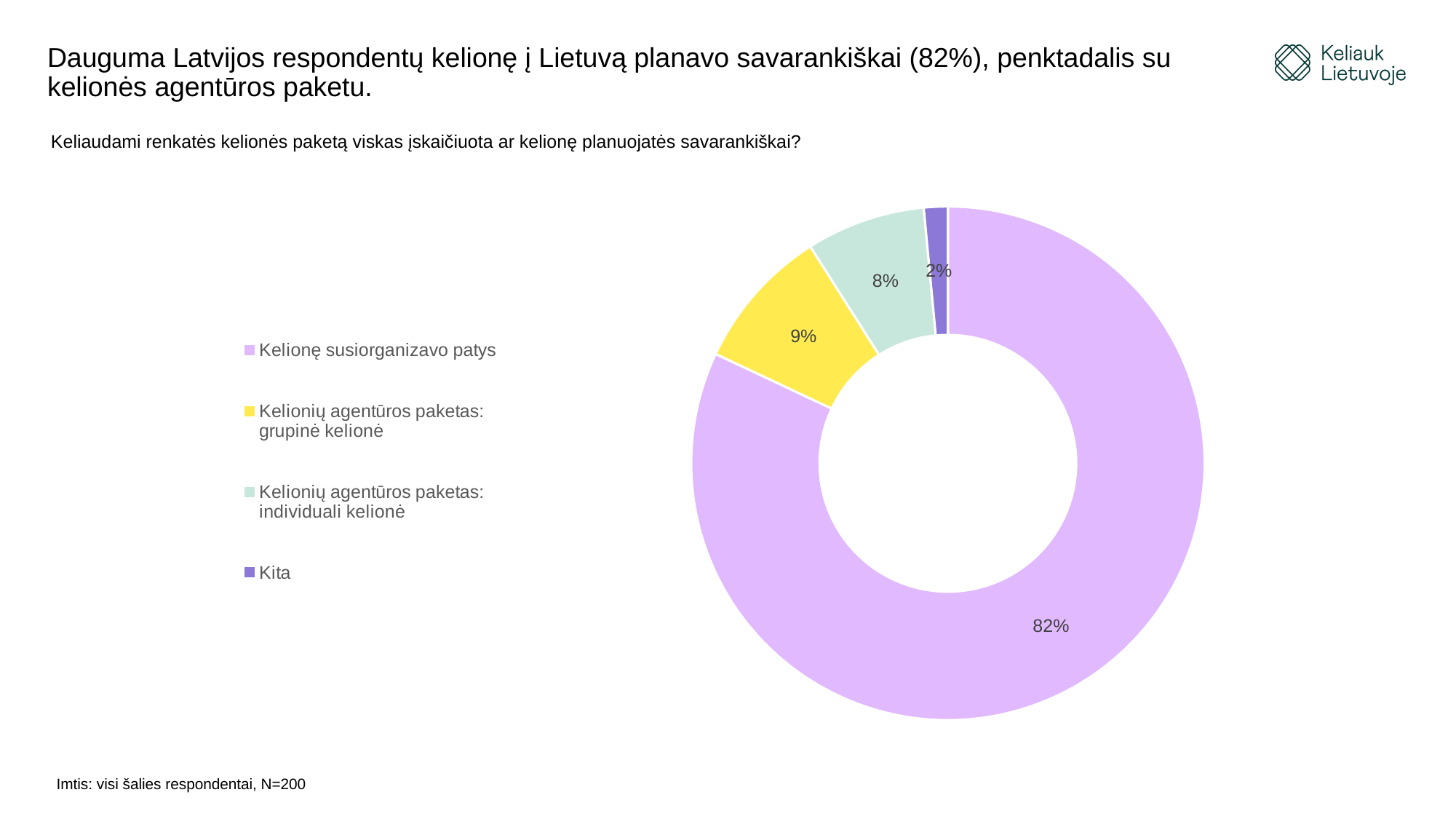
How many categories are shown in the chart? 4 What is the difference in percentage points between "Kelionę susiorganizavo patys" and "Kelionių agentūros paketas: grupinė kelionė"? 73 percentage points What kind of chart is shown on the slide? Doughnut (pie) chart Which is larger: the share for "Kelionių agentūros paketas: grupinė kelionė" or for "Kelionių agentūros paketas: individuali kelionė"? Kelionių agentūros paketas: grupinė kelionė What share of respondents chose "Kelionę susiorganizavo patys"? 82% What colour is the slice for "Kita"? Purple What is the combined share of the two travel agency package categories? 17% What share of respondents chose "Kelionių agentūros paketas: individuali kelionė"? 8% What share of respondents chose "Kita"? 2% What share of respondents chose "Kelionių agentūros paketas: grupinė kelionė"? 9% Which category has the largest share of the chart? Kelionę susiorganizavo patys Which category has the smallest share of the chart? Kita